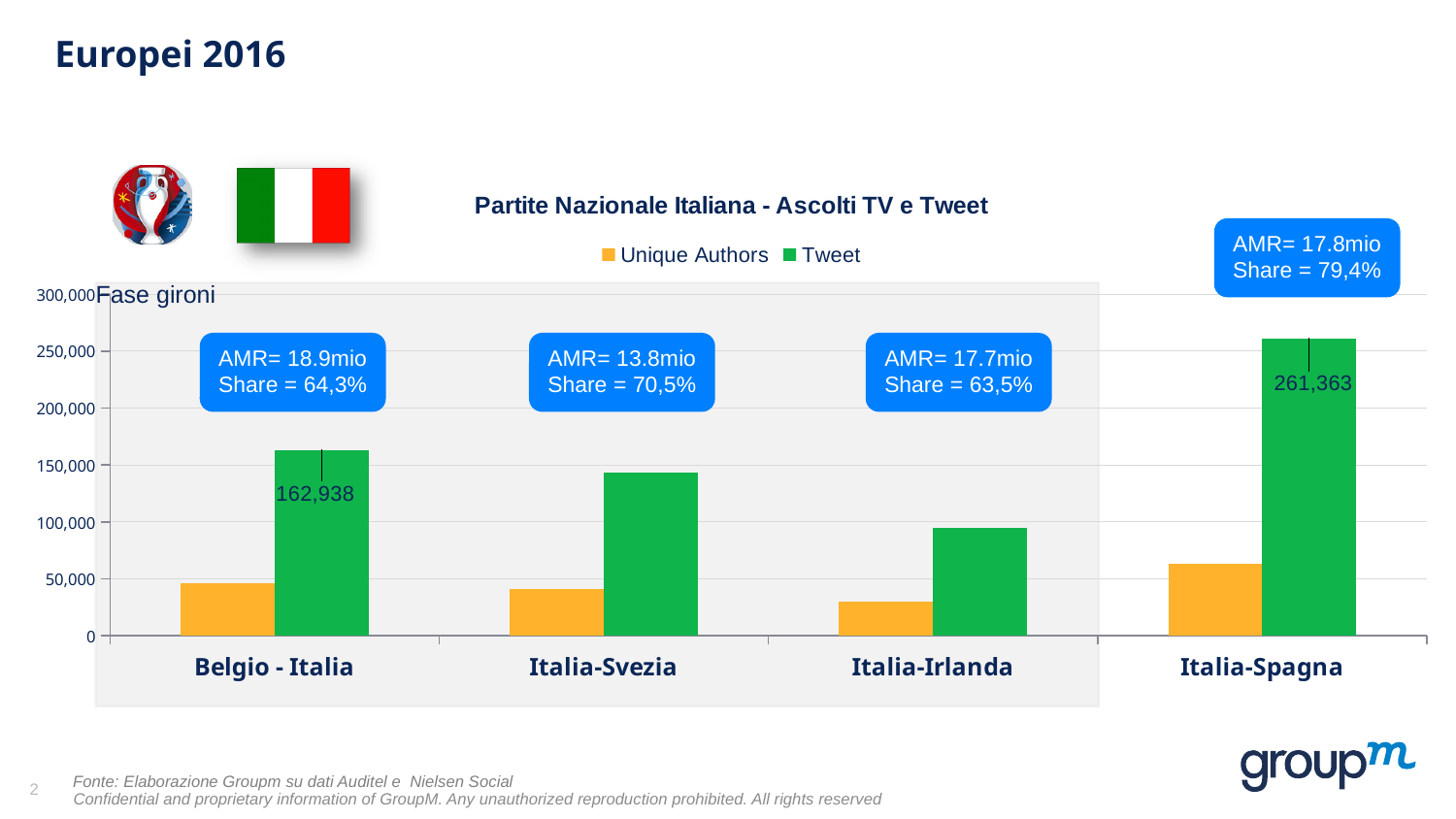
What is the Tweet value for Belgio - Italia? 162,938 How many matches are shown on the x axis of the chart? 4 What is the difference between the Tweet values for Italia-Spagna and Belgio - Italia? 98,425 What is the Tweet value for Italia-Spagna? 261,363 Is the Unique Authors value for Italia-Spagna greater or less than 50,000? greater Which match has the highest Tweet value? Italia-Spagna What type of chart is shown on the slide? Bar chart Which is larger, the Tweet value for Italia-Svezia or for Italia-Irlanda? Italia-Svezia Which match has the lowest Unique Authors value? Italia-Irlanda Which match has the lowest Tweet value? Italia-Irlanda How many series does the chart legend list? 2 Is the Unique Authors value for Italia-Irlanda greater or less than 50,000? less